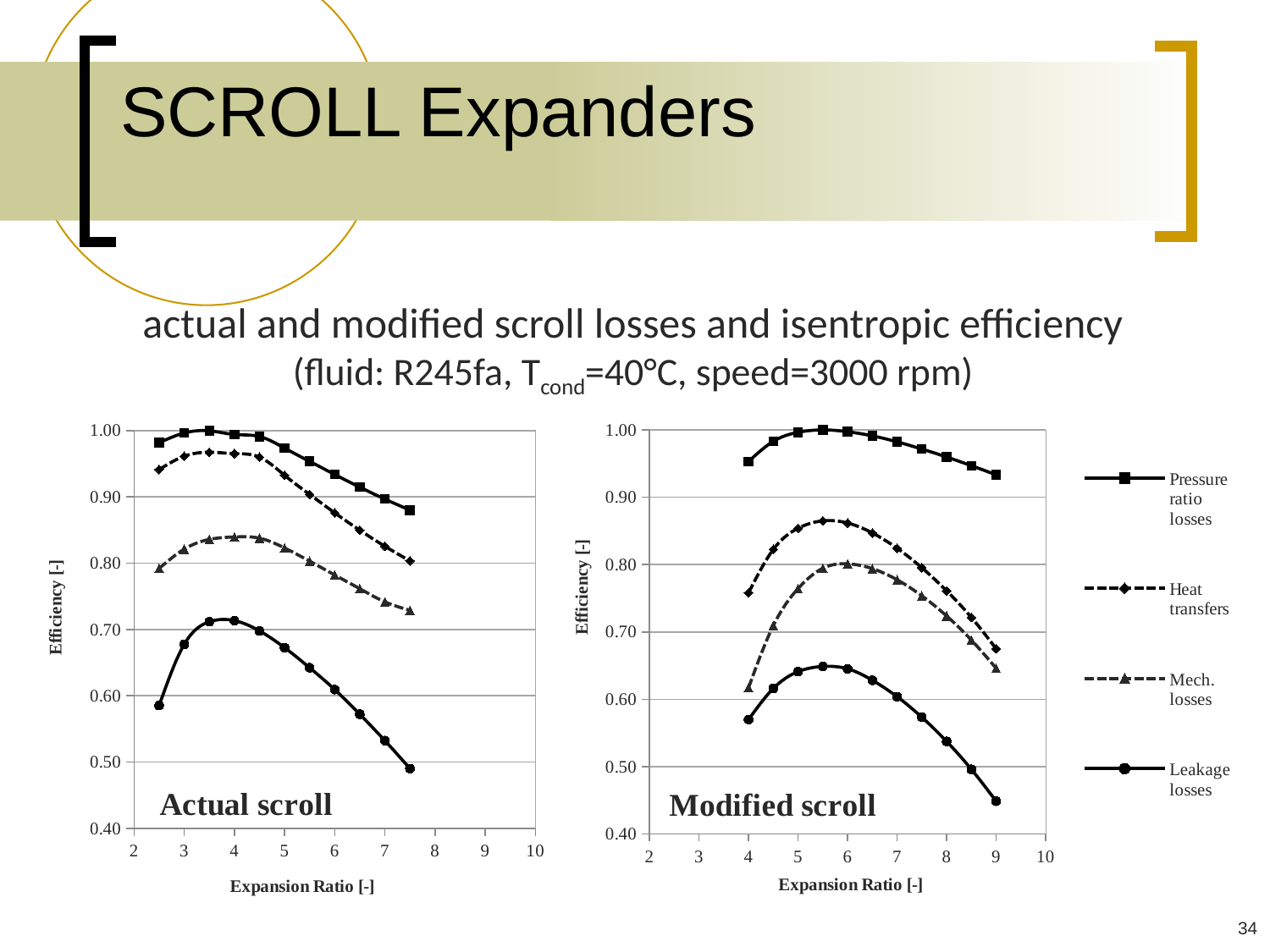
What is the x-axis label of the Modified scroll chart? Expansion Ratio [-] In the Modified scroll chart, which series has the highest efficiency values across the whole range? Pressure ratio losses In the Actual scroll chart, is the Pressure ratio losses value at an expansion ratio of 7.5 greater or less than 0.80? greater In the Actual scroll chart, at an expansion ratio of 7.5, which is higher: Heat transfers or Mech. losses? Heat transfers How many series does the legend list for the charts? 4 In the Actual scroll chart, which series has the lowest efficiency values across the whole range? Leakage losses In the Actual scroll chart, is the Leakage losses value at an expansion ratio of 7.5 greater or less than 0.60? less In the Modified scroll chart, is the Leakage losses value at an expansion ratio of 9 greater or less than 0.50? less In the Actual scroll chart, does the Leakage losses curve rise or fall as the expansion ratio increases from 4 to 7.5? fall What kind of chart is the Actual scroll chart on the left? line chart What is the y-axis label of the Actual scroll chart? Efficiency [-]